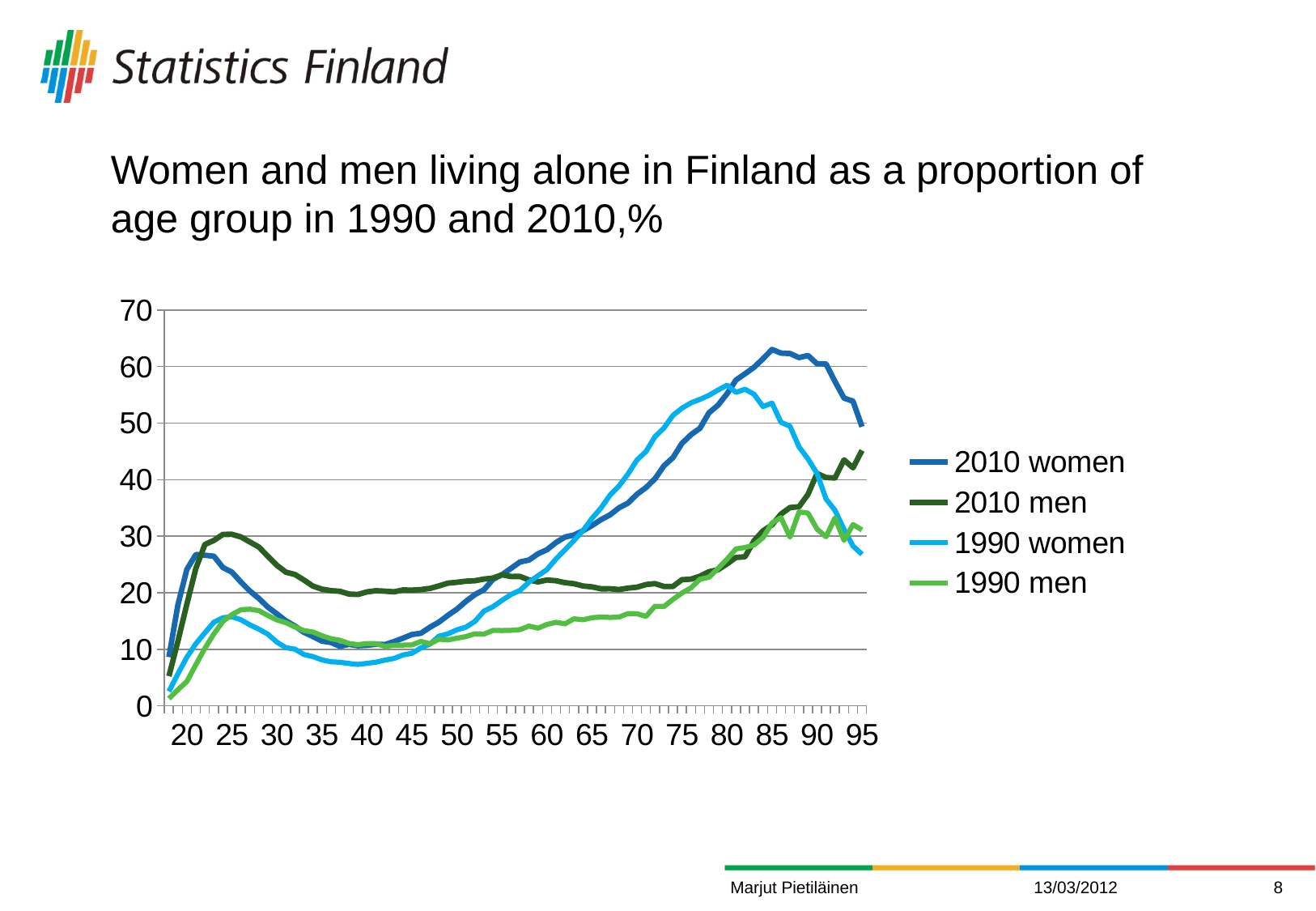
Does the 1990 women line rise or fall between age 80 and age 95? fall Is the value for 2010 men at age 40 greater or less than 30? less What are the four series named in the legend? 2010 women, 2010 men, 1990 women, 1990 men Is the value for 1990 women at age 80 greater or less than 50? greater At age 85, which series has the higher value: 2010 women or 2010 men? 2010 women Is the value for 1990 men at age 40 greater or less than 20? less What kind of chart is shown on the slide? line chart At age 25, which series has the higher value: 2010 men or 2010 women? 2010 men At age 30, which series has the higher value: 2010 men or 1990 men? 2010 men How many series does the legend list? 4 Which series reaches the highest value anywhere on the chart? 2010 women